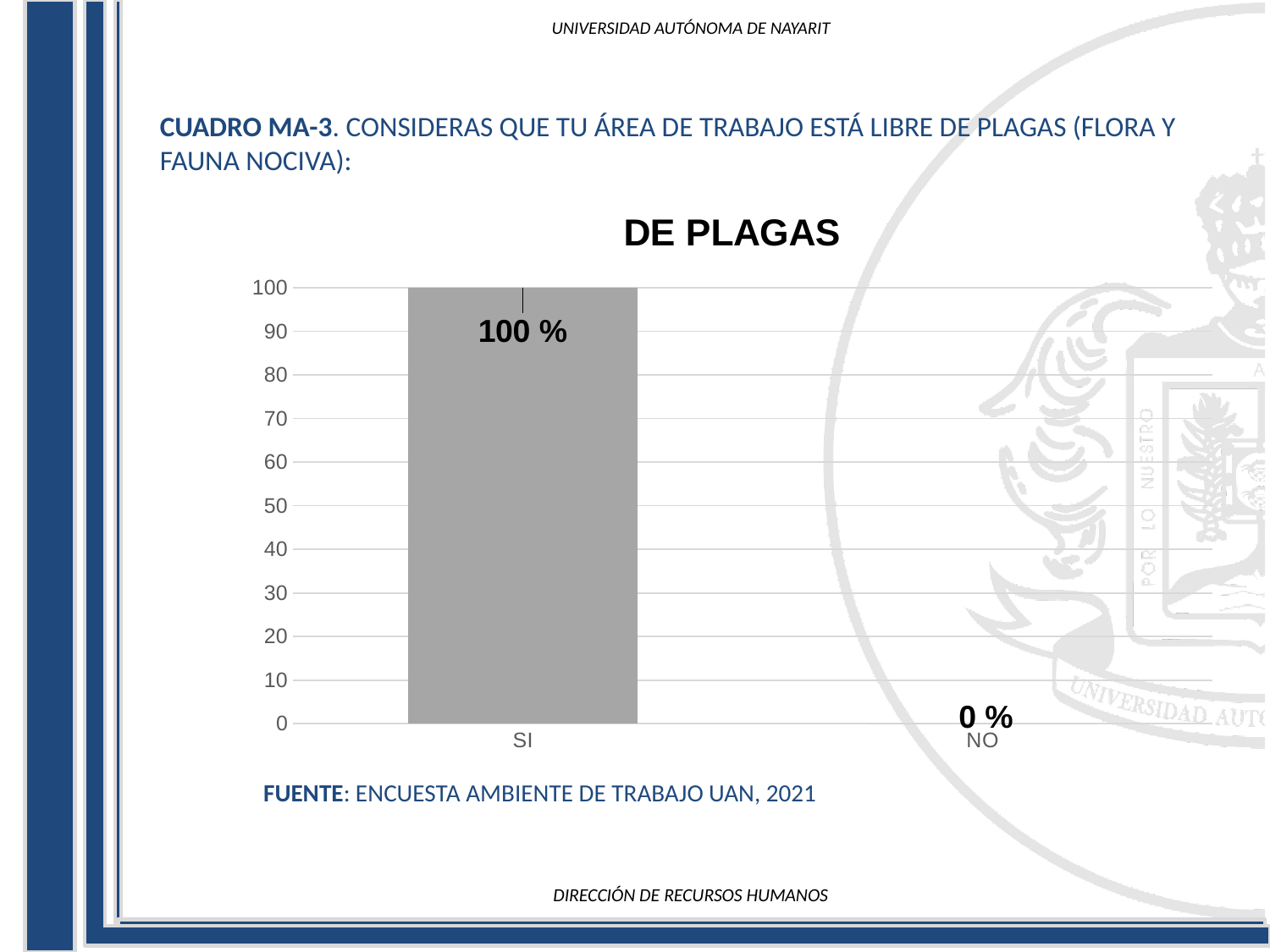
Which category has the lowest value? NO What is the value for SI? 100 % What is the highest value shown on the vertical axis? 100 Is the value for SI greater or less than 50? greater Which is larger, the value for SI or the value for NO? SI What kind of chart is shown? bar chart What is the title of the chart? DE PLAGAS What is the difference between the values for SI and NO? 100 % Which category has the highest value? SI How many categories are shown on the x axis? 2 What is the value for NO? 0 %